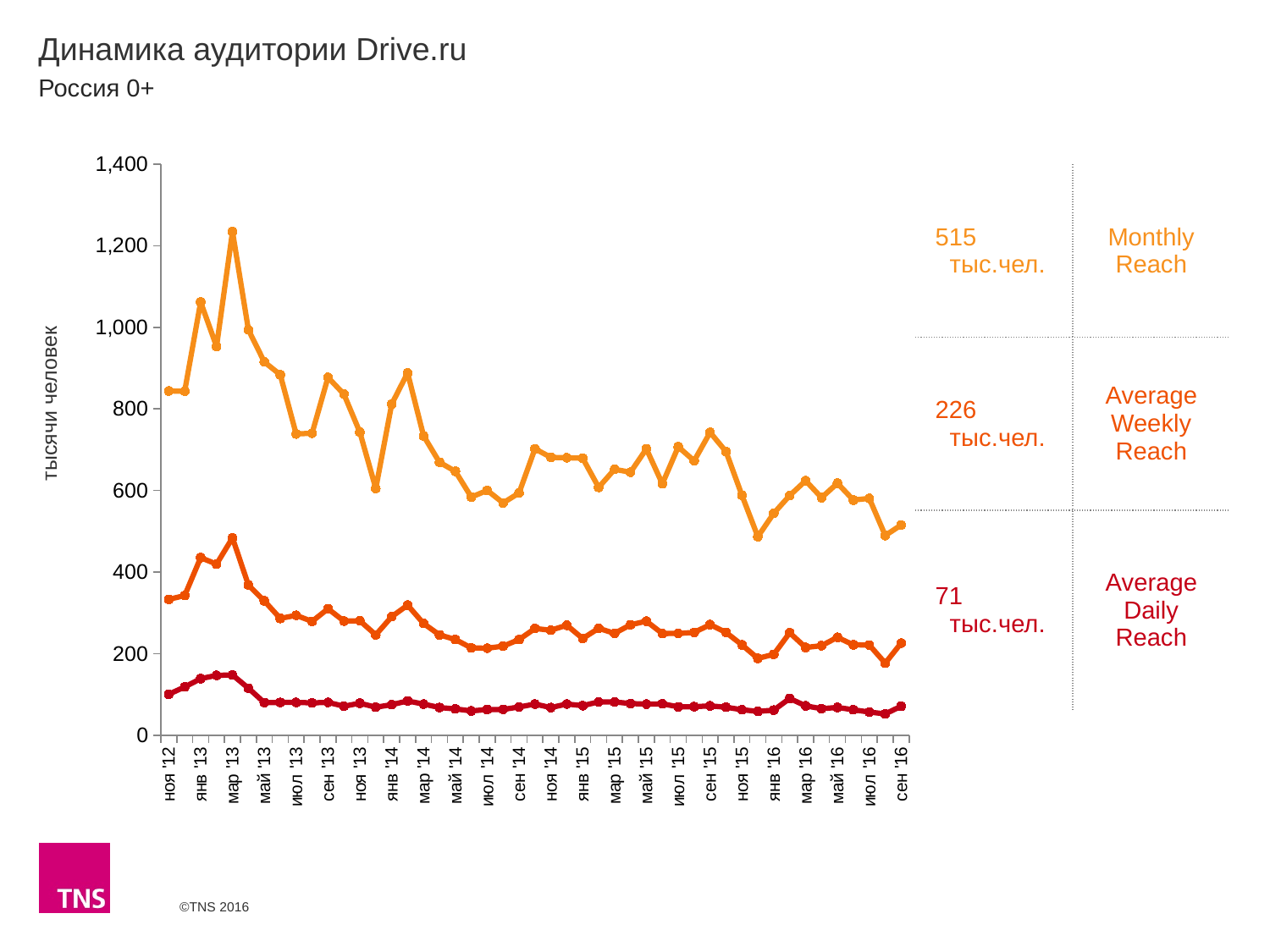
What is the label on the vertical axis of the chart? тысячи человек What is the Average Daily Reach value shown for the latest month (сен '16)? 71 тыс.чел. Which is larger for сен '16: Monthly Reach or Average Weekly Reach? Monthly Reach What is the Average Weekly Reach value shown for the latest month (сен '16)? 226 тыс.чел. What is the difference between the Monthly Reach (515) and the Average Weekly Reach (226) shown for сен '16? 289 тыс.чел. Is the Average Daily Reach value in мар '13 greater or less than 200? less In which month does the Monthly Reach line reach its highest point? мар '13 How many series are plotted on the chart? 3 What is the Monthly Reach value shown for the latest month (сен '16)? 515 тыс.чел. What kind of chart is shown on the slide? line chart Is the peak Monthly Reach value in мар '13 greater or less than 1,200? greater Does the Monthly Reach line overall rise or fall from ноя '12 to сен '16? fall